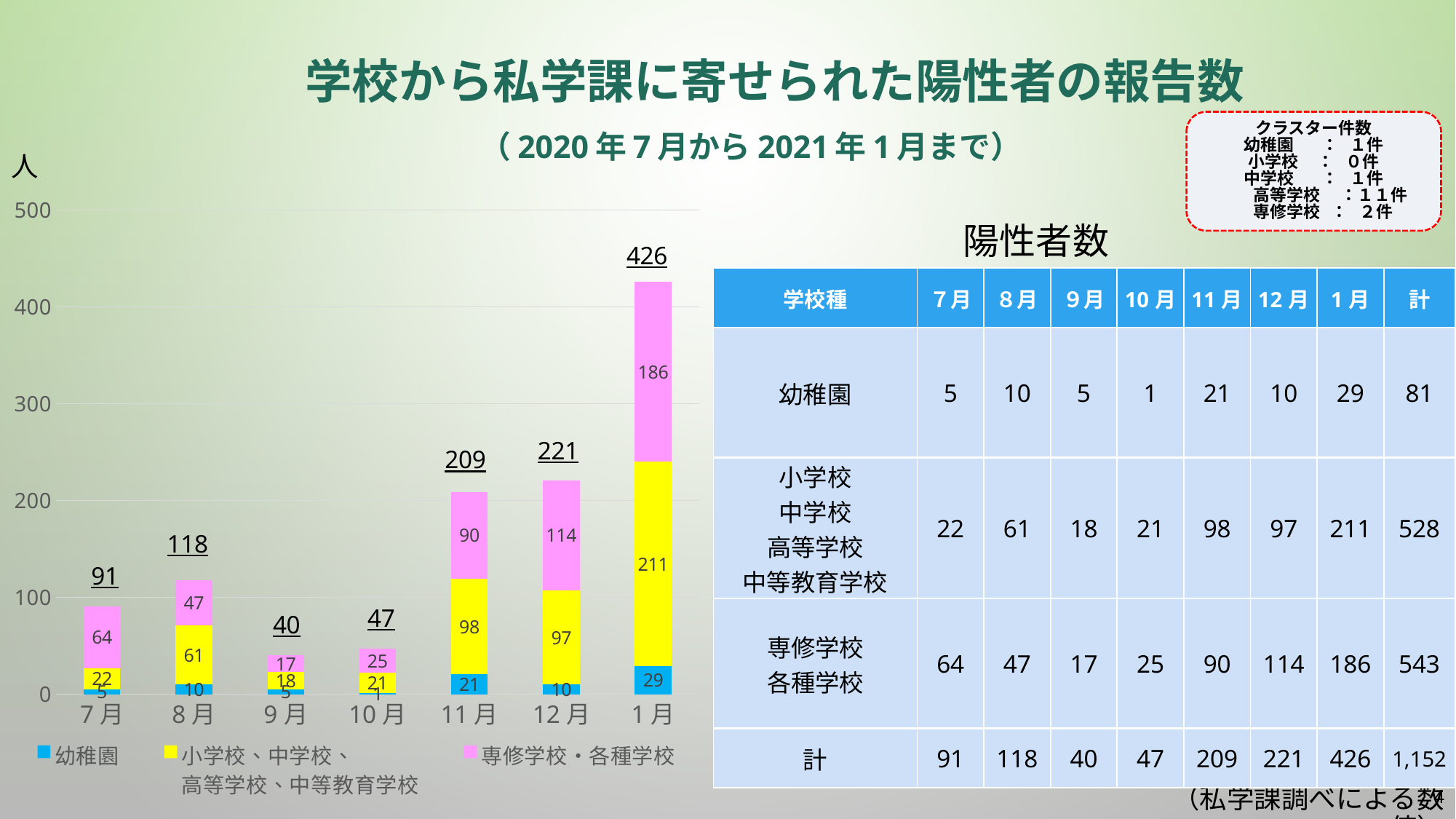
Which is larger, the 専修学校・各種学校 value in 12月 or in 11月? 12月 What is the value for 幼稚園 in 1月? 29 How many series does the chart legend list? 3 What is the value for 専修学校・各種学校 in 11月? 90 What is the value for 小学校、中学校、高等学校、中等教育学校 in 8月? 61 Which month has the lowest total bar? 9月 What is the total value labeled above the bar for 1月? 426 What type of chart is shown on the slide? stacked bar chart How many months are plotted on the x axis of the chart? 7 Which month has the highest total bar? 1月 What is the difference between the total for 12月 and the total for 11月? 12 Is the total bar for 1月 greater or less than 400? greater